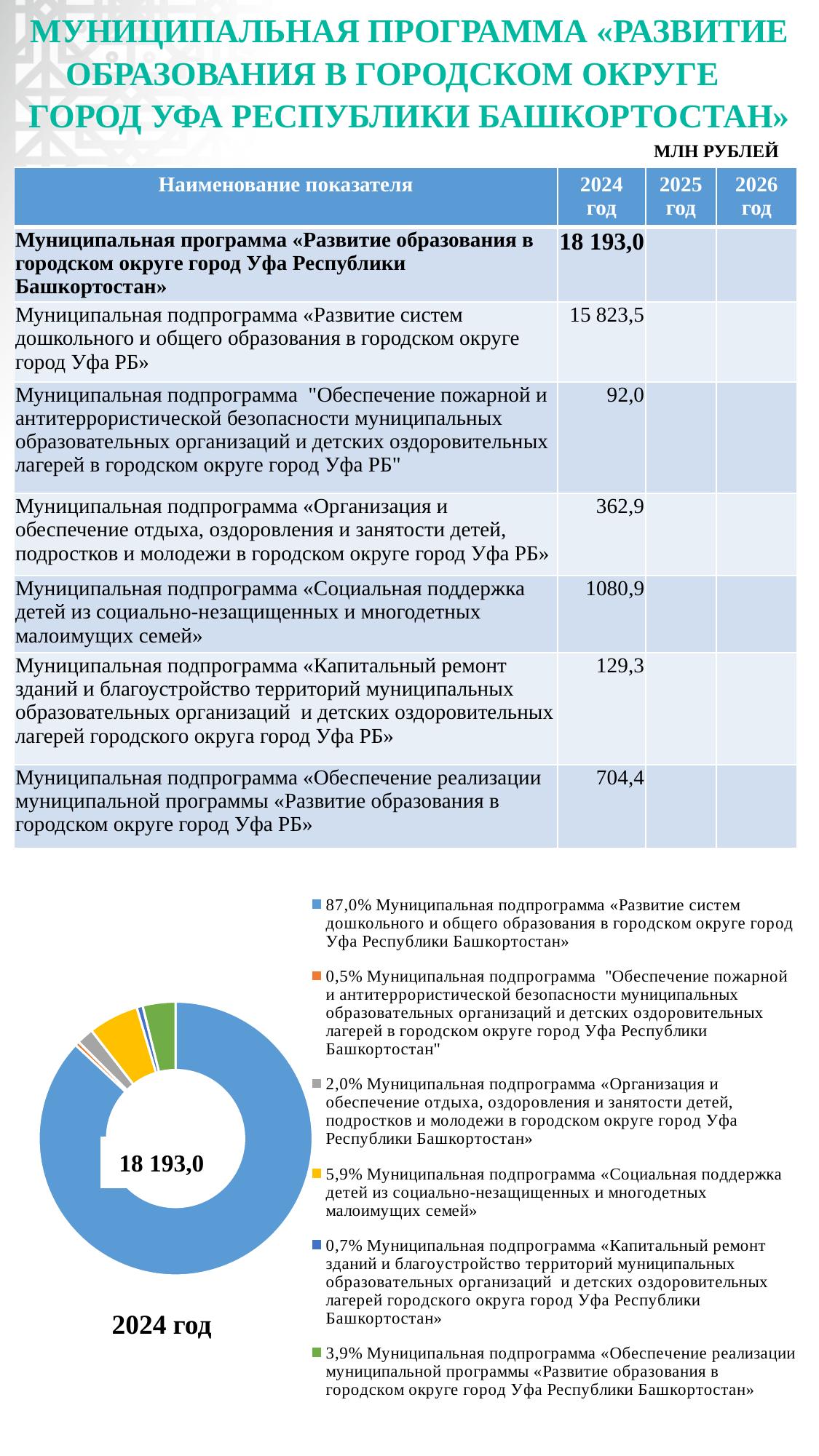
What share of the doughnut chart does the subprogramme «Обеспечение реализации муниципальной программы» take? 3,9% What share of the doughnut chart does the subprogramme «Развитие систем дошкольного и общего образования» take? 87,0% What total value is printed in the centre of the doughnut chart? 18 193,0 In the doughnut chart, which share is larger: «Социальная поддержка детей» or «Обеспечение реализации муниципальной программы»? «Социальная поддержка детей» (5,9%) What kind of chart is shown at the bottom of the slide? Doughnut (pie) chart What is the difference in share between «Социальная поддержка детей» (5,9%) and «Обеспечение реализации муниципальной программы» (3,9%) in the doughnut chart? 2,0% Which subprogramme has the largest share in the doughnut chart? «Развитие систем дошкольного и общего образования» (87,0%) What share of the doughnut chart does the subprogramme «Социальная поддержка детей из социально-незащищенных и многодетных малоимущих семей» take? 5,9% How many slices (subprogrammes) does the doughnut chart show? 6 Which year is the doughnut chart labelled with? 2024 год Which subprogramme has the smallest share in the doughnut chart? «Обеспечение пожарной и антитеррористической безопасности» (0,5%)